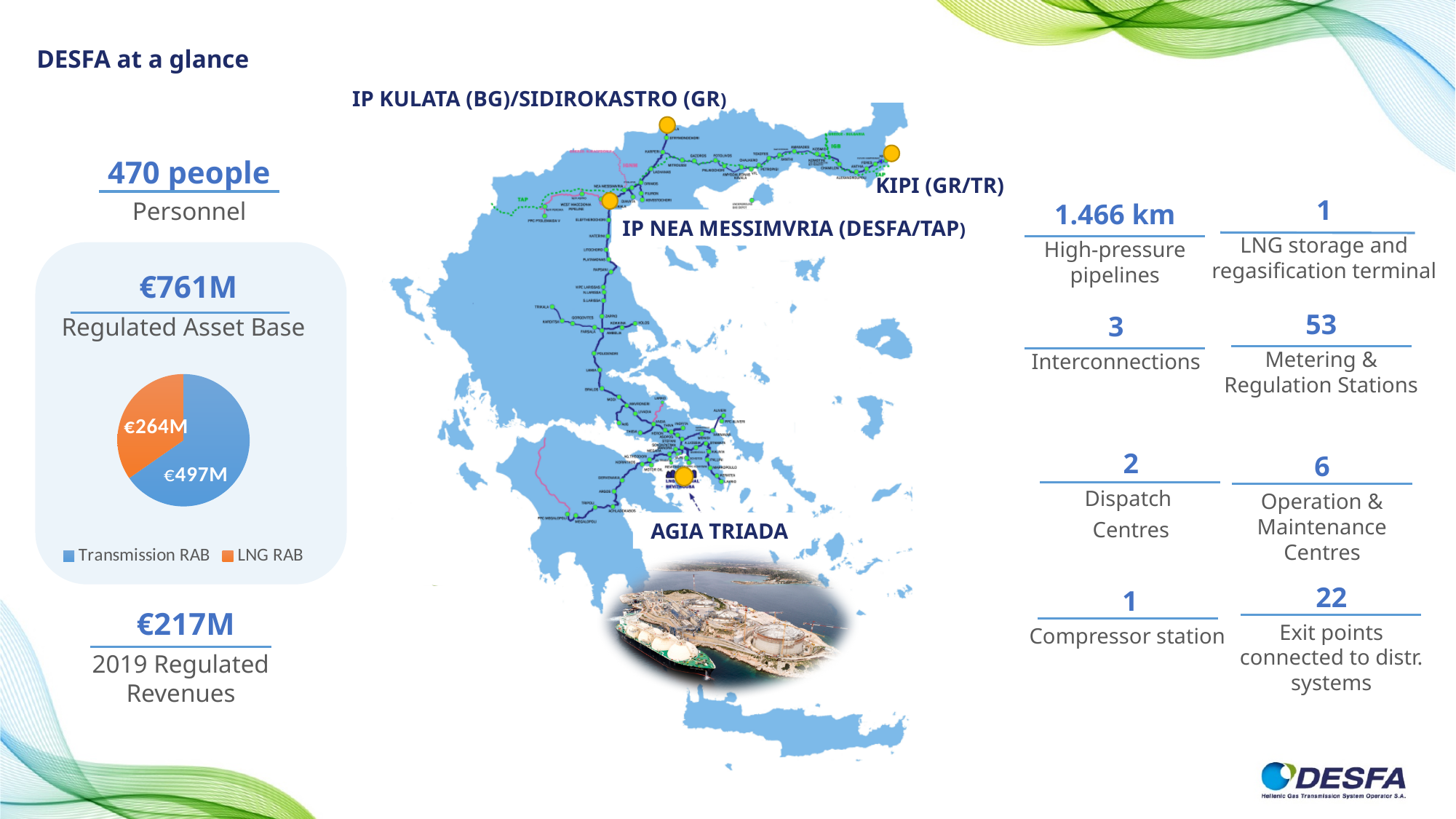
Which slice of the pie chart is the smallest? LNG RAB How many entries does the pie chart legend list? 2 What colour is the LNG RAB slice in the pie chart? orange What is the value of the Transmission RAB slice in the pie chart? €497M What is the difference between the Transmission RAB and LNG RAB values in the pie chart? €233M How many slices does the pie chart have? 2 What label appears above the pie chart describing the €761M figure? Regulated Asset Base Which slice of the pie chart is the largest? Transmission RAB What is the value of the LNG RAB slice in the pie chart? €264M What type of chart is shown on the slide? pie chart Which is larger in the pie chart, Transmission RAB or LNG RAB? Transmission RAB What is the total of the two slices in the pie chart? €761M